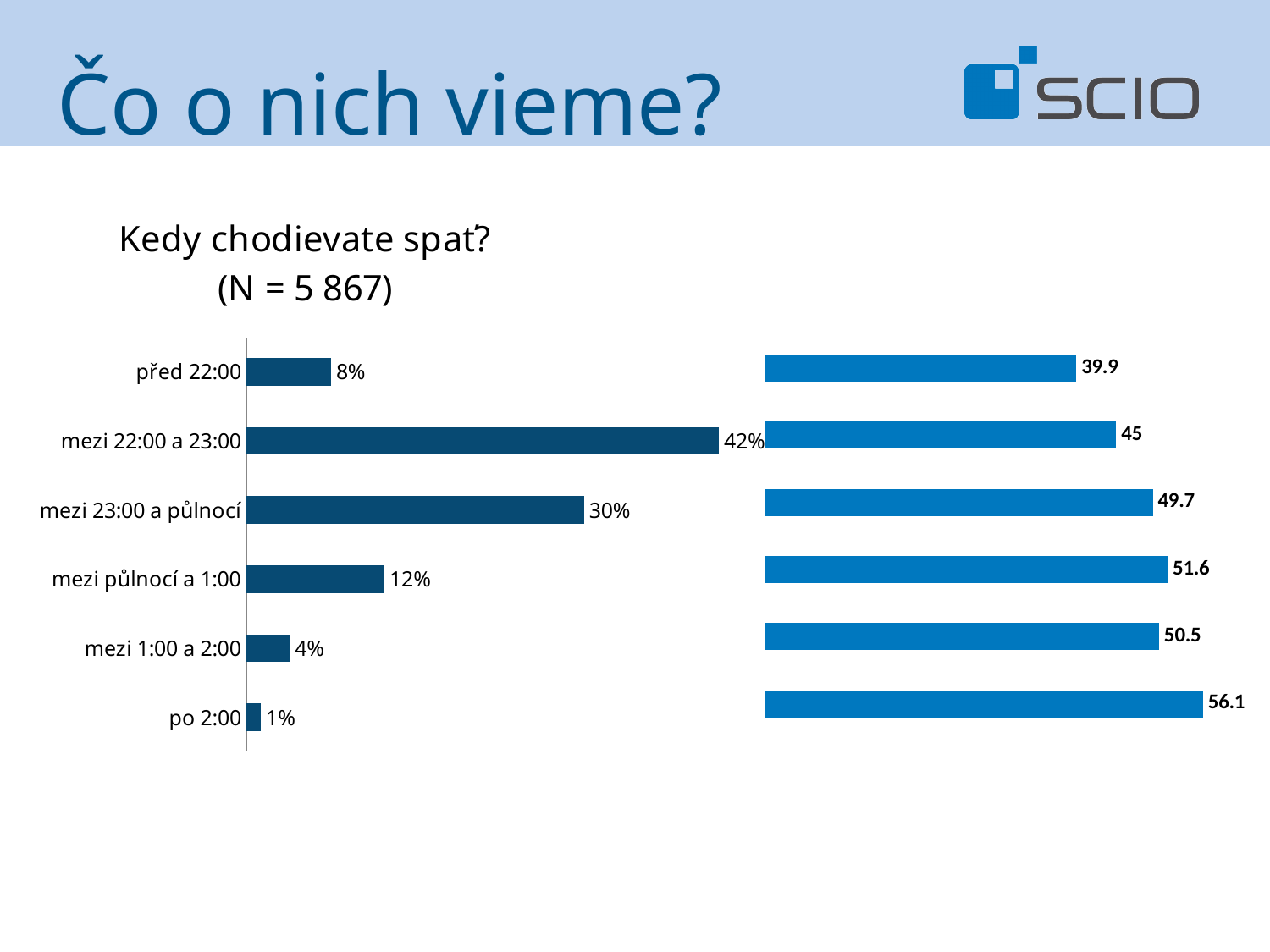
What type of chart is the left chart? bar chart In the left chart, which category has the highest value? mezi 22:00 a 23:00 In the left chart, what is the difference between the values for 'mezi 22:00 a 23:00' and 'mezi 23:00 a půlnocí'? 12% In the left chart, which category has the lowest value? po 2:00 In the right chart, what is the value of the bottom bar? 56.1 In the left chart, what is the value for 'po 2:00'? 1% In the right chart, what is the difference between the bottom bar and the top bar? 16.2 What is the sample size (N) stated in the title of the left chart? 5 867 In the right chart, what is the value of the top bar? 39.9 How many categories does the left chart show? 6 In the left chart, what percentage of respondents go to sleep between 22:00 and 23:00 (mezi 22:00 a 23:00)? 42% In the left chart, which is larger: the value for 'před 22:00' or the value for 'mezi půlnocí a 1:00'? mezi půlnocí a 1:00